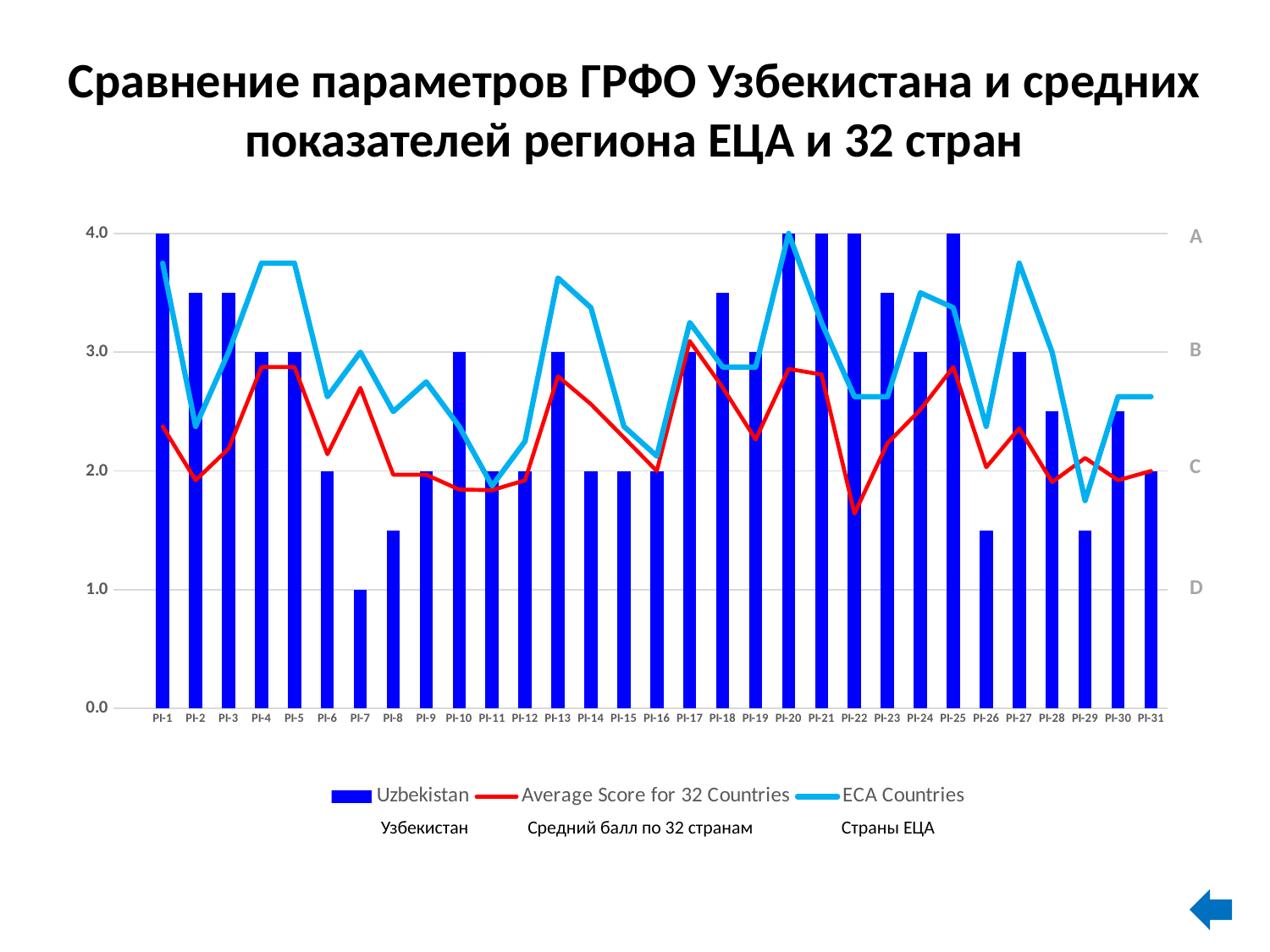
How many categories (PI indicators) are shown on the x axis? 31 Which category has the lowest Uzbekistan bar? PI-7 What is the Uzbekistan value for PI-7? 1.0 Is the Average Score for 32 Countries value for PI-22 greater or less than 2.0? less What is the Uzbekistan value for PI-13? 3.0 Is the ECA Countries value for PI-29 greater or less than 2.0? less Which has the larger Uzbekistan value, PI-20 or PI-26? PI-20 How many series does the legend list? 3 What is the Uzbekistan value for PI-16? 2.0 What is the difference between the Uzbekistan values for PI-1 and PI-7? 3.0 What is the Uzbekistan value for PI-1? 4.0 What kind of chart is this? Combined bar and line chart